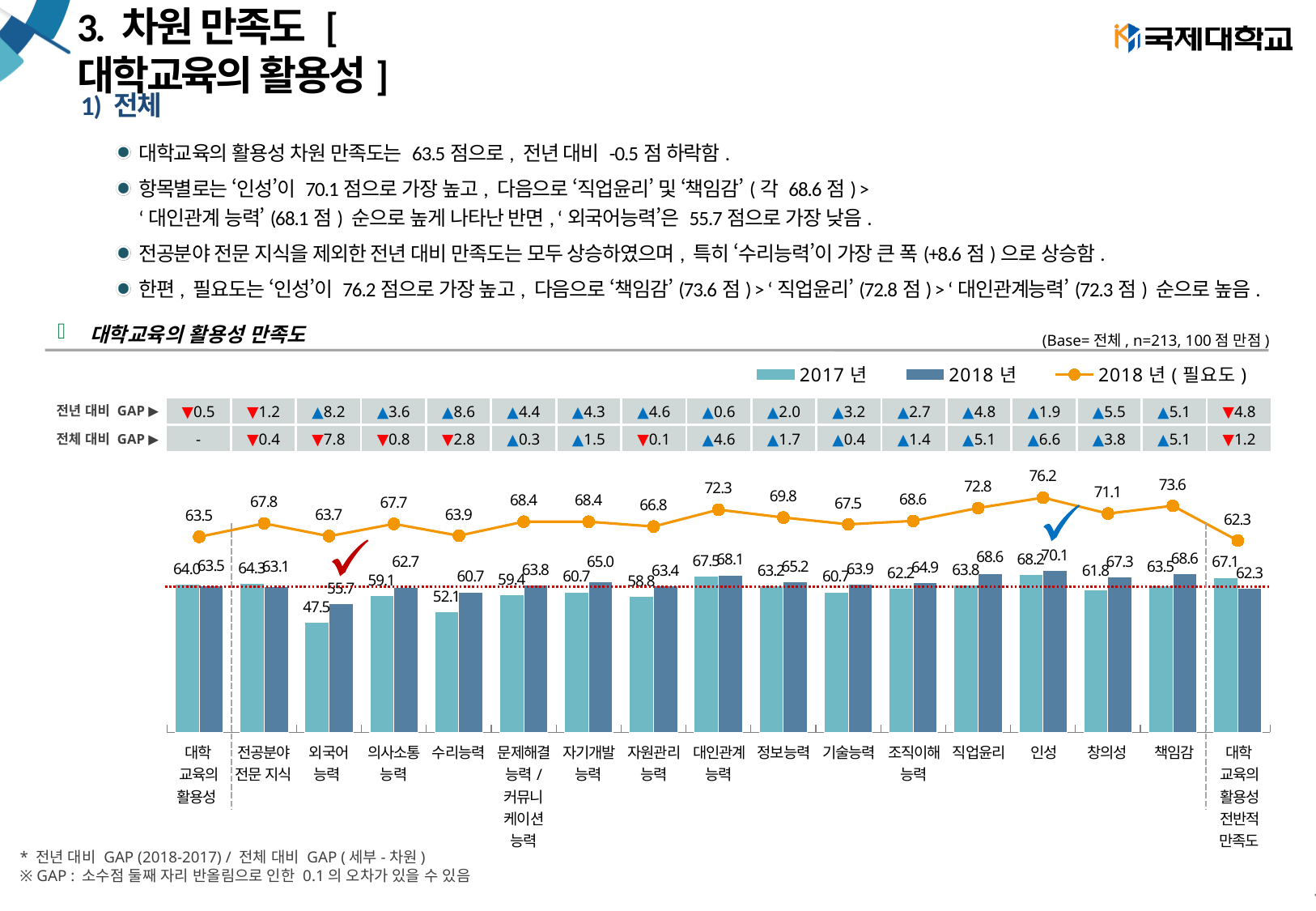
Which is larger for 전공분야 전문 지식: the 2017년 value or the 2018년 value? 2017년 Which is larger for 대인관계능력: the 2017년 value or the 2018년 value? 2018년 What is the 2017년 value for 외국어능력? 47.5 What is the difference between the 2018년 and 2017년 values for 외국어능력? 8.2 What is the 2018년 value for 인성? 70.1 How many categories are shown on the x axis of the chart? 17 How many series does the chart legend list? 3 What is the 2018년 (필요도) value for 책임감? 73.6 Which category has the lowest 2017년 value? 외국어능력 Which category has the highest 2018년 (필요도) value? 인성 What kind of chart is this? Bar chart with a line series What is the 2018년 value for 수리능력? 60.7